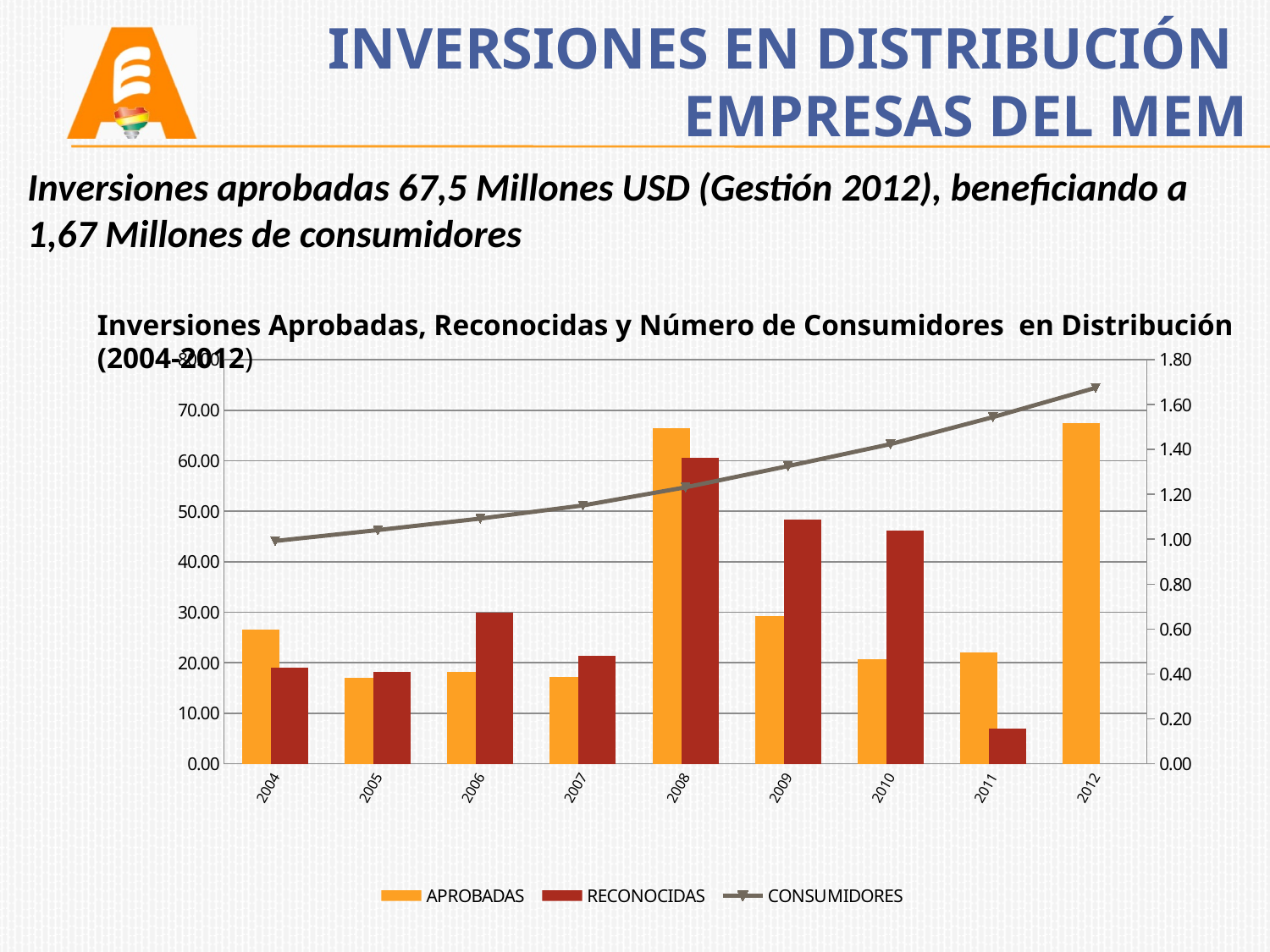
Is the CONSUMIDORES value for 2012 greater or less than 1.60 on the right axis? greater Does the CONSUMIDORES line rise or fall from 2004 to 2012? rise In which year is the RECONOCIDAS bar the highest? 2008 In which year is the RECONOCIDAS bar the lowest? 2011 In 2009, which is larger: APROBADAS or RECONOCIDAS? RECONOCIDAS Is the RECONOCIDAS value for 2011 greater or less than 10? less How many years are shown on the x axis of the chart? 9 Is the RECONOCIDAS value for 2010 greater or less than 40? greater What kind of chart is shown on the slide? Combined bar and line chart In 2004, which is larger: APROBADAS or RECONOCIDAS? APROBADAS How many series does the chart legend list? 3